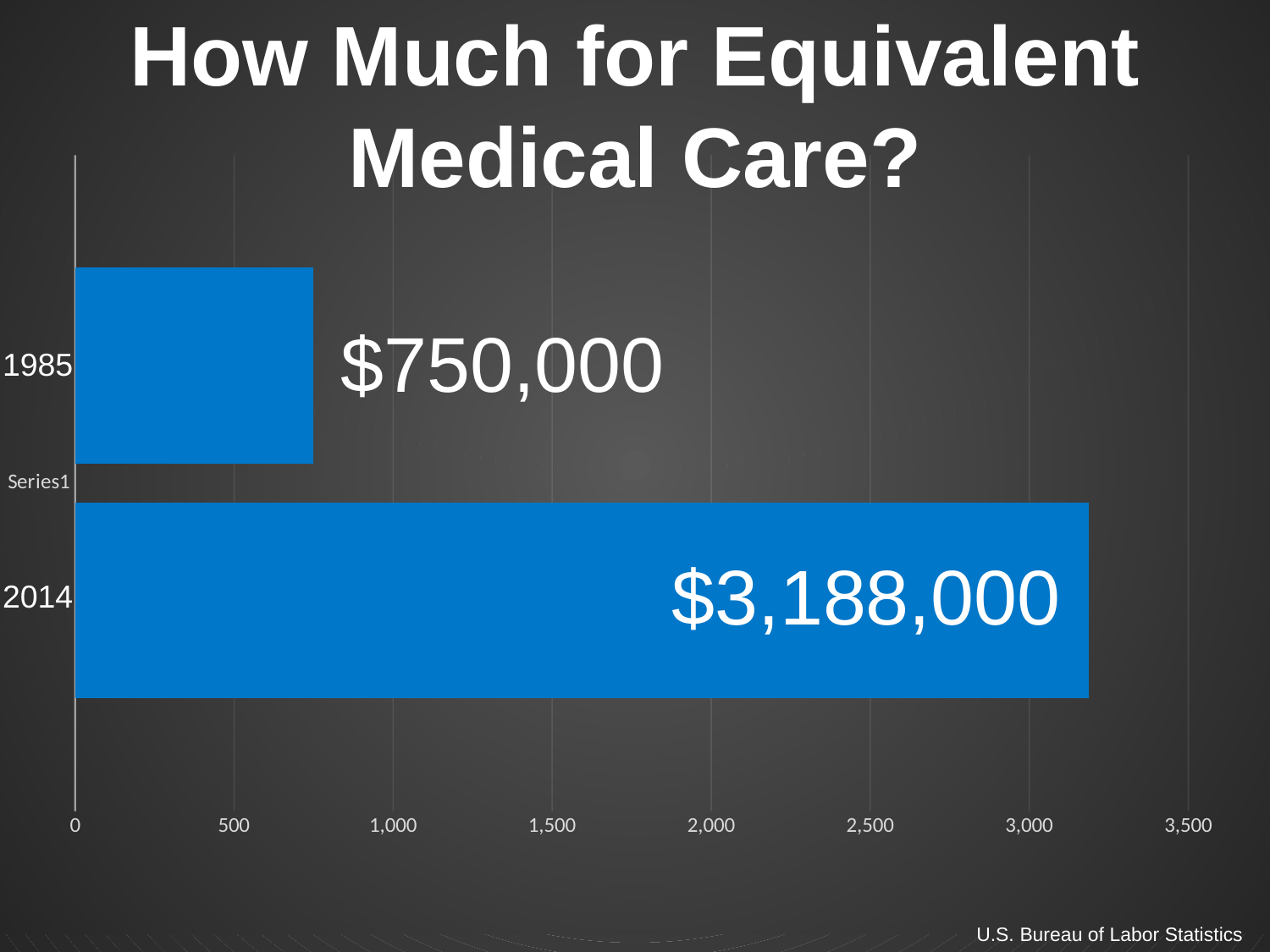
Is the bar for 1985 greater or less than 500 on the axis? greater What kind of chart is shown on the slide? bar chart Which year has the lower value? 1985 Is the value for 2014 larger or smaller than the value for 1985? larger What is the value shown for 1985? $750,000 Which year has the higher value? 2014 What source is cited at the bottom of the slide? U.S. Bureau of Labor Statistics What is the difference between the 2014 value and the 1985 value? $2,438,000 What is the value shown for 2014? $3,188,000 What is the title of the slide? How Much for Equivalent Medical Care? How many bars are plotted in the chart? 2 Is the bar for 2014 greater or less than 3,000 on the axis? greater